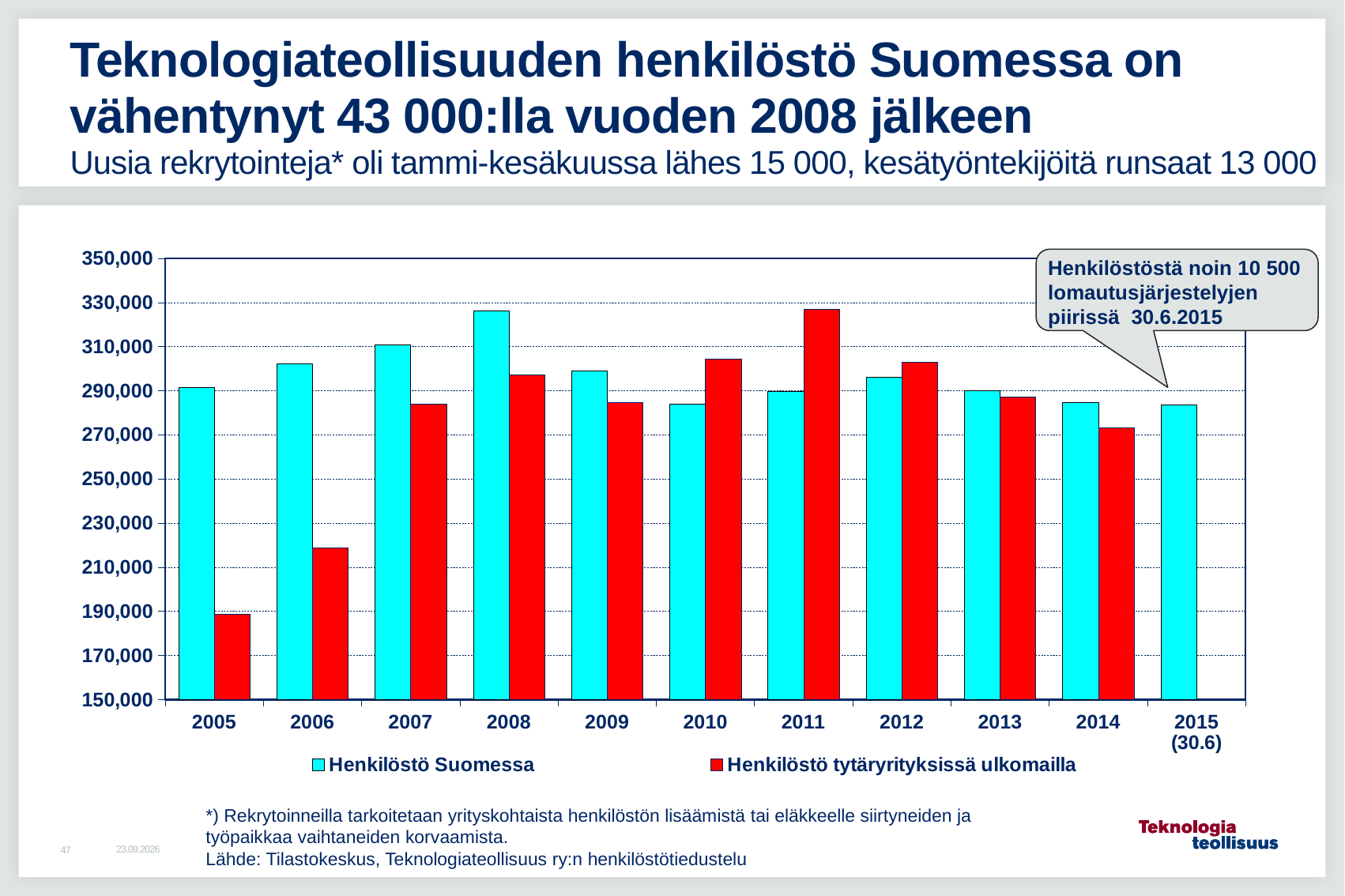
Is the value for Henkilöstö tytäryrityksissä ulkomailla in 2006 greater or less than 210,000? greater How many series does the legend list? 2 In which year is the value for Henkilöstö tytäryrityksissä ulkomailla lowest? 2005 In which year is the value for Henkilöstö Suomessa highest? 2008 In which year is the value for Henkilöstö tytäryrityksissä ulkomailla highest? 2011 What kind of chart is shown on the slide? bar chart Does the value for Henkilöstö tytäryrityksissä ulkomailla rise or fall from 2005 to 2008? rise In 2005, which series has the larger value: Henkilöstö Suomessa or Henkilöstö tytäryrityksissä ulkomailla? Henkilöstö Suomessa How many years (categories) are shown on the x axis? 11 Is the value for Henkilöstö tytäryrityksissä ulkomailla in 2014 greater or less than 290,000? less In 2011, which series has the larger value: Henkilöstö Suomessa or Henkilöstö tytäryrityksissä ulkomailla? Henkilöstö tytäryrityksissä ulkomailla Is the value for Henkilöstö Suomessa in 2008 greater or less than 310,000? greater